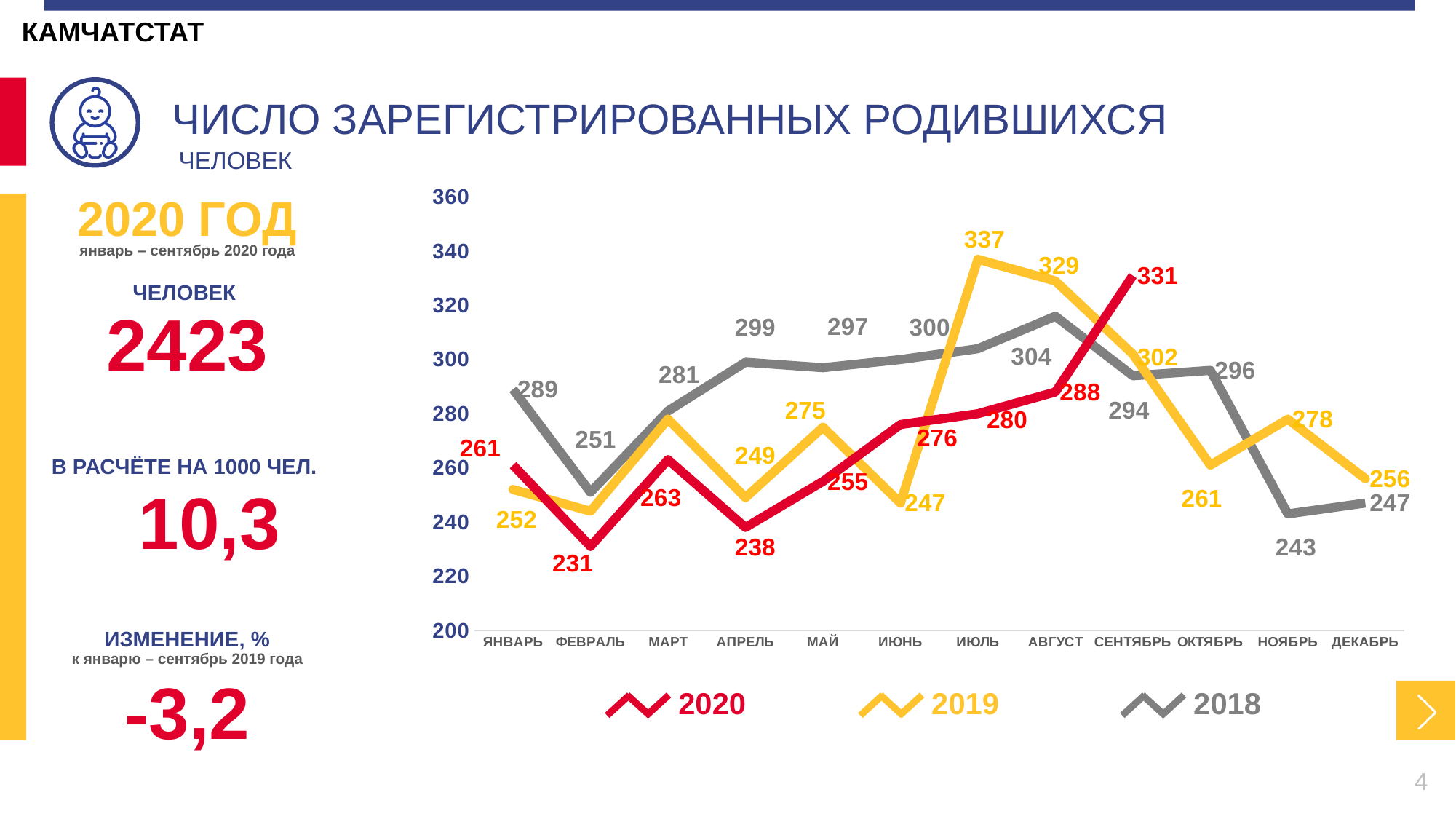
Is the value for АВГУСТ in the 2018 series greater or less than 300? greater What colour is the line for the 2019 series? yellow In which month does the 2020 series have its lowest value? ФЕВРАЛЬ How many series does the legend list? 3 Which series has the larger value in ИЮНЬ, 2020 or 2019? 2020 What is the difference between the 2020 values for СЕНТЯБРЬ and АВГУСТ? 43 How many months are shown on the x axis? 12 What is the value for НОЯБРЬ in the 2018 series? 243 What is the value for СЕНТЯБРЬ in the 2020 series? 331 What is the value for ИЮЛЬ in the 2019 series? 337 In which month does the 2020 series reach its highest value? СЕНТЯБРЬ What kind of chart is shown on the slide? line chart